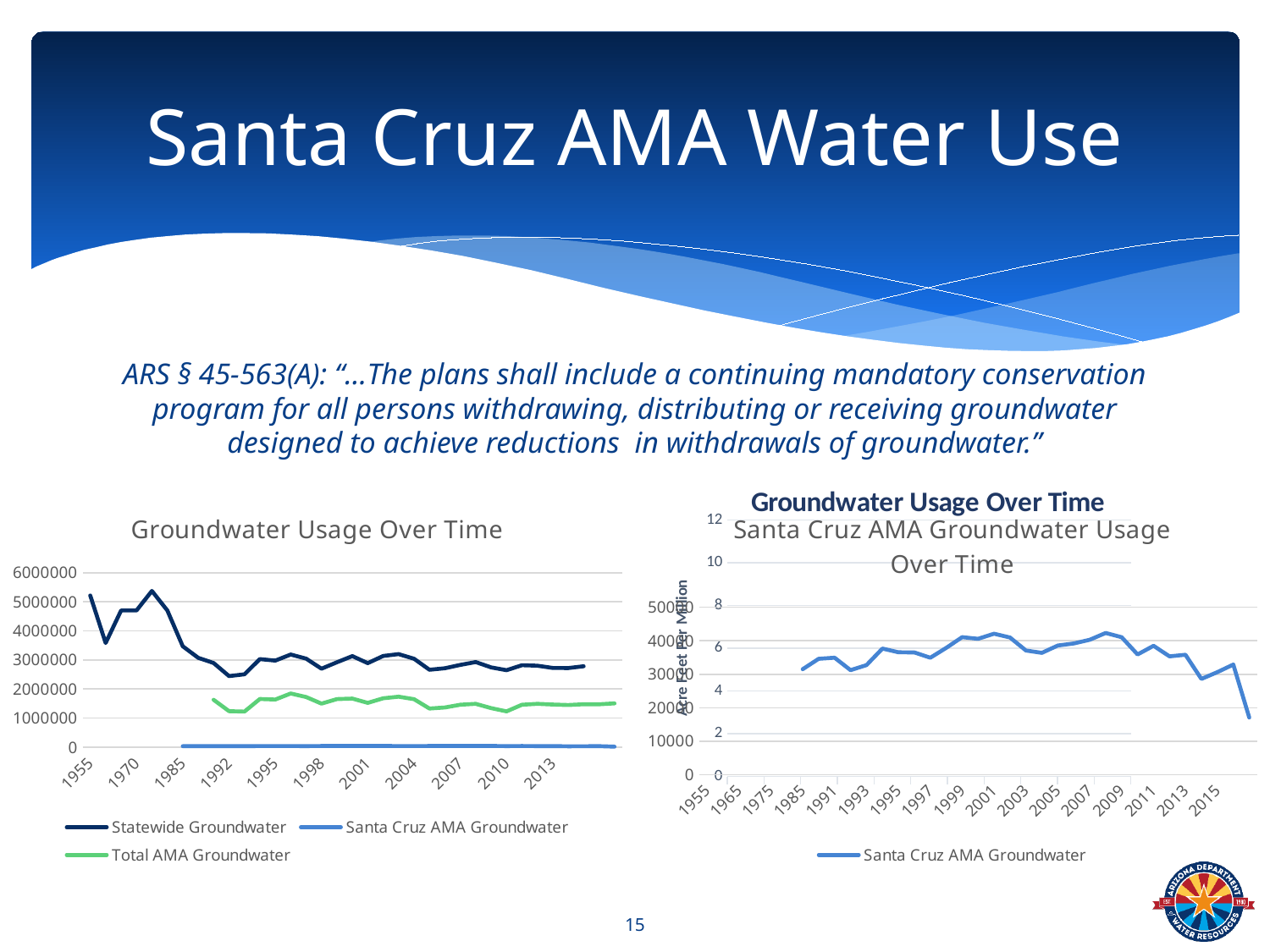
In the left chart, which is larger in 2004: Statewide Groundwater or Total AMA Groundwater? Statewide Groundwater In the left chart, which series has the lowest values throughout? Santa Cruz AMA Groundwater What type of chart is the left chart titled 'Groundwater Usage Over Time'? Line chart What are the series names in the legend of the left chart? Statewide Groundwater, Santa Cruz AMA Groundwater, Total AMA Groundwater In the right chart, does the Santa Cruz AMA Groundwater line rise or fall from 2009 to the end of the series? Fall How many series does the legend of the right chart list? 1 In the left chart, is the Statewide Groundwater value in 1955 greater or less than 4000000? greater In the left chart, does the Statewide Groundwater series overall rise or fall from 1955 to 2013? Fall How many series does the legend of the left chart list? 3 In the left chart, which series has the highest values throughout? Statewide Groundwater What type of chart is the right chart showing Santa Cruz AMA Groundwater Usage Over Time? Line chart In the left chart, is the Total AMA Groundwater value in 2013 greater or less than 2000000? less